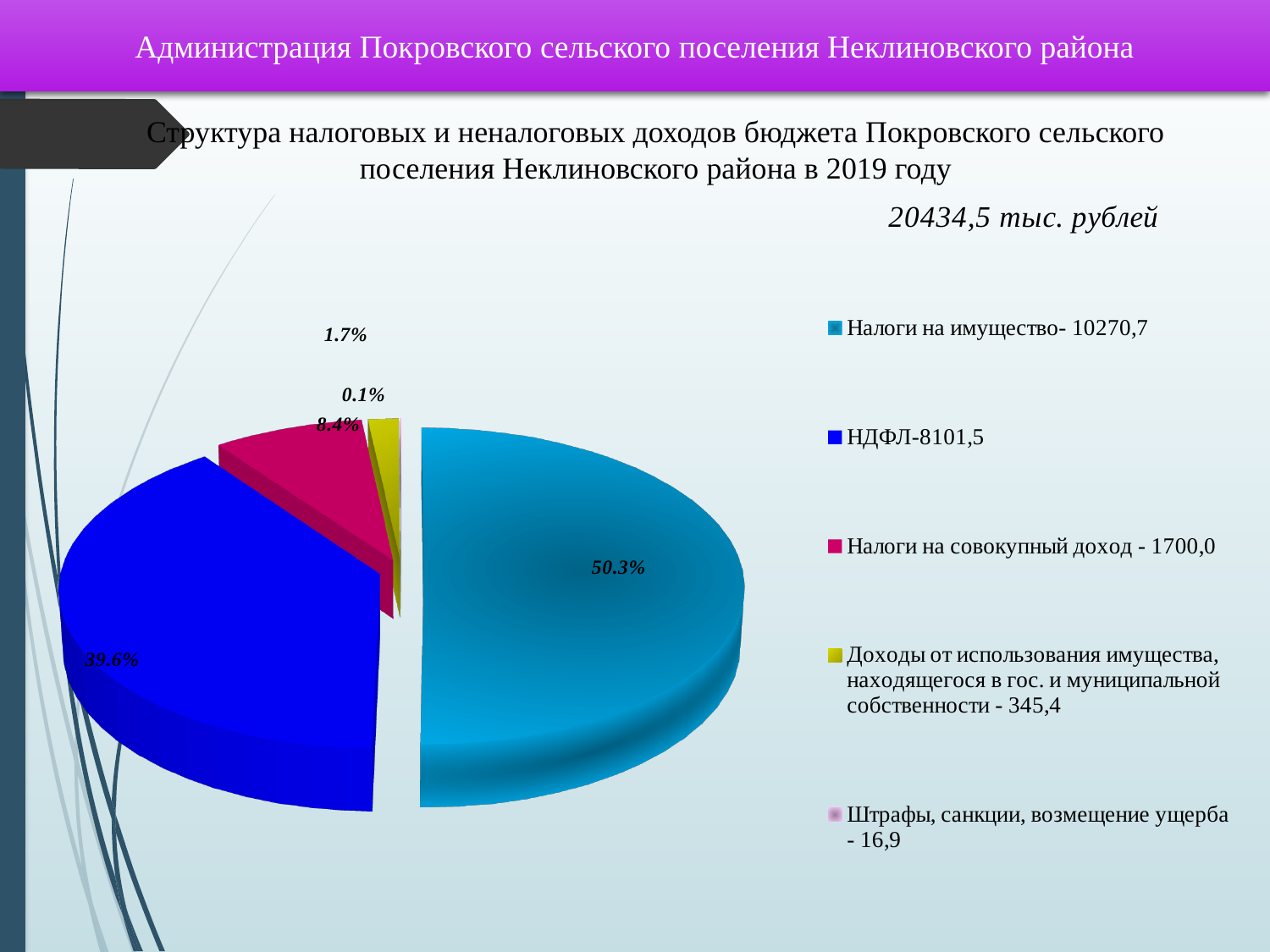
How many entries does the legend list? 5 Which category has the largest slice of the pie? Налоги на имущество Which category has the smallest slice of the pie? Штрафы, санкции, возмещение ущерба What share of the pie does the slice for Налоги на имущество take? 50.3% Which is larger: the share for НДФЛ or the share for Налоги на совокупный доход? НДФЛ What share of the pie does the slice for Налоги на совокупный доход take? 8.4% How many slices does the pie chart have? 5 What value is given in the legend for НДФЛ? 8101,5 What value is given in the legend for Штрафы, санкции, возмещение ущерба? 16,9 What kind of chart is shown on the slide? pie chart What share of the pie does the slice for НДФЛ take? 39.6% What is the difference in percentage points between the share for Налоги на имущество and the share for НДФЛ? 10.7